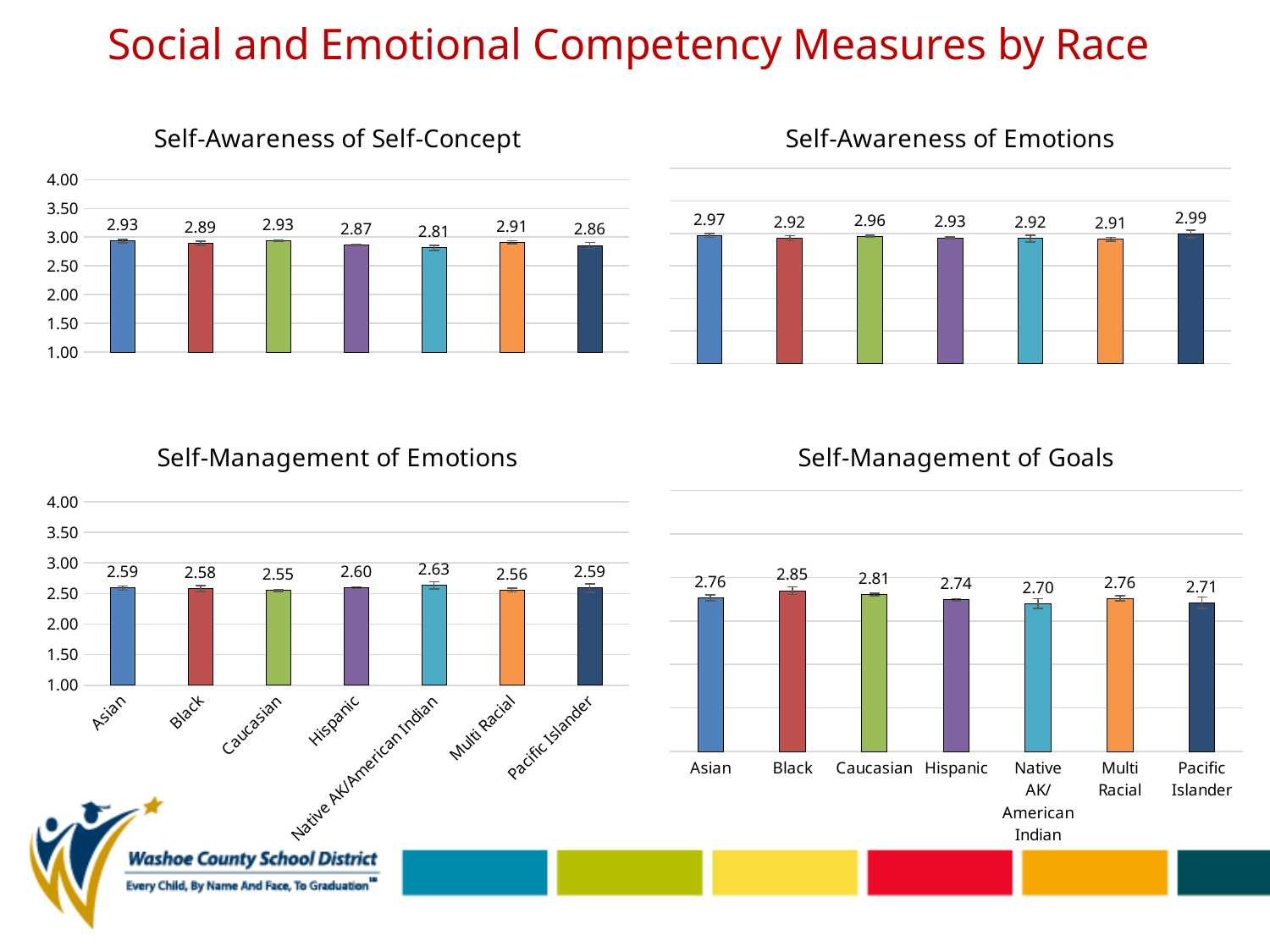
What kind of chart is the Self-Management of Emotions chart? Bar chart In the Self-Management of Goals chart, what is the value for Black? 2.85 In the Self-Management of Emotions chart, which category has the lowest value? Caucasian How many charts are shown on the slide? 4 How many categories are shown in the Self-Management of Goals chart? 7 In the Self-Management of Goals chart, which is larger, the value for Caucasian or the value for Hispanic? Caucasian In the Self-Management of Emotions chart, what is the value for Hispanic? 2.60 In the Self-Awareness of Self-Concept chart, what is the lowest value shown? 2.81 In the Self-Management of Emotions chart, which category has the highest value? Native AK/American Indian In the Self-Management of Goals chart, what is the difference between the values for Black and Native AK/American Indian? 0.15 In the Self-Management of Goals chart, which category has the lowest value? Native AK/American Indian In the Self-Awareness of Emotions chart, what is the highest value shown? 2.99